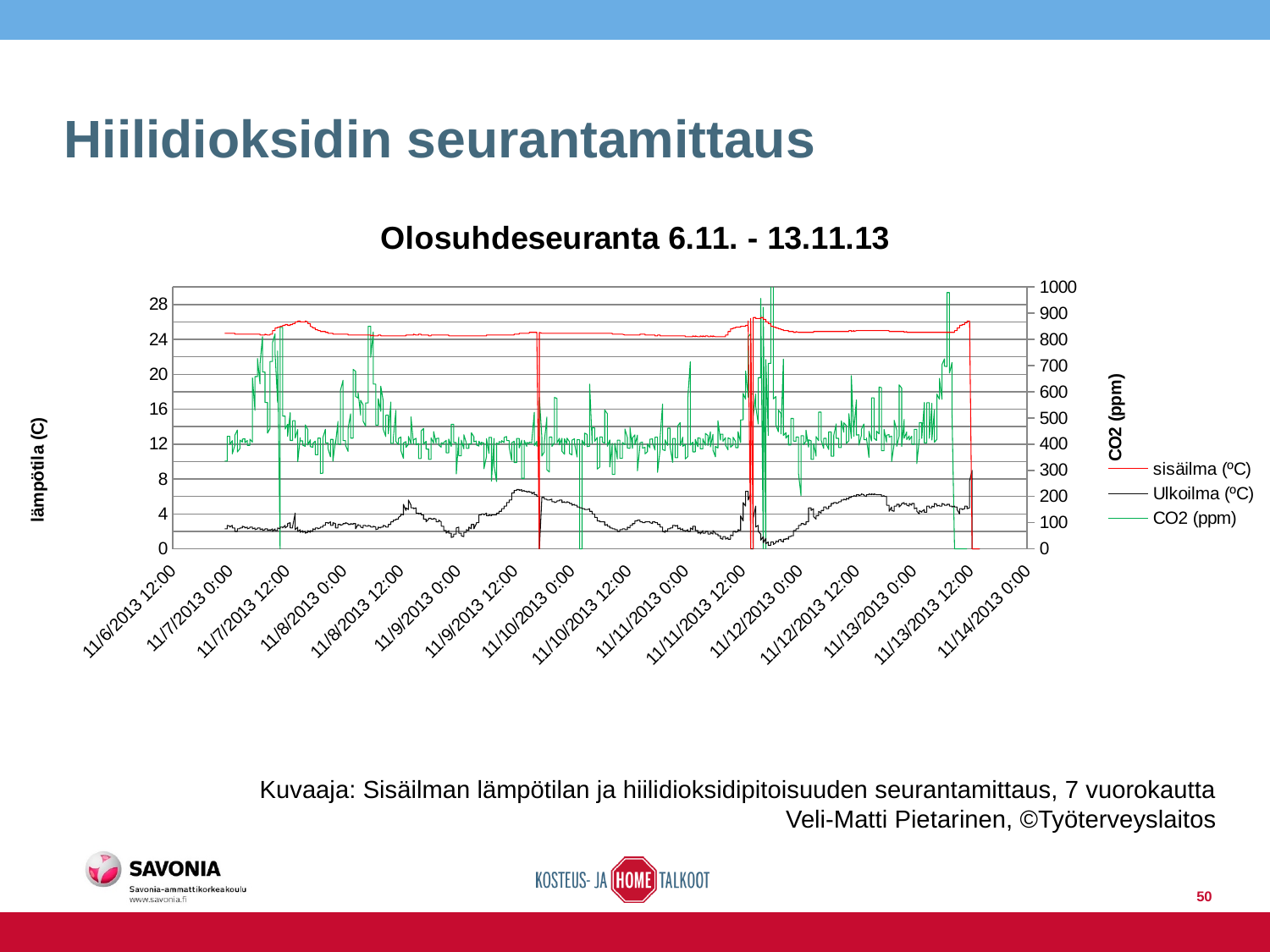
At 11/10/2013 12:00, which is higher: sisäilma (ºC) or Ulkoilma (ºC)? sisäilma (ºC) How many series does the chart legend list? 3 Is the sisäilma (ºC) value at 11/9/2013 0:00 greater or less than 20? greater Is the Ulkoilma (ºC) value at 11/8/2013 0:00 greater or less than 12? less What is the highest tick value shown on the right-hand CO2 (ppm) axis? 1000 Which of the two temperature series, sisäilma (ºC) or Ulkoilma (ºC), stays higher throughout the measurement period? sisäilma (ºC) What is the label of the right-hand vertical axis? CO2 (ppm) What kind of chart is shown on the slide? line chart How many date/time labels are shown along the x axis? 16 Is the CO2 (ppm) value at 11/9/2013 0:00 greater or less than 800? less What is the title of the chart? Olosuhdeseuranta 6.11. - 13.11.13